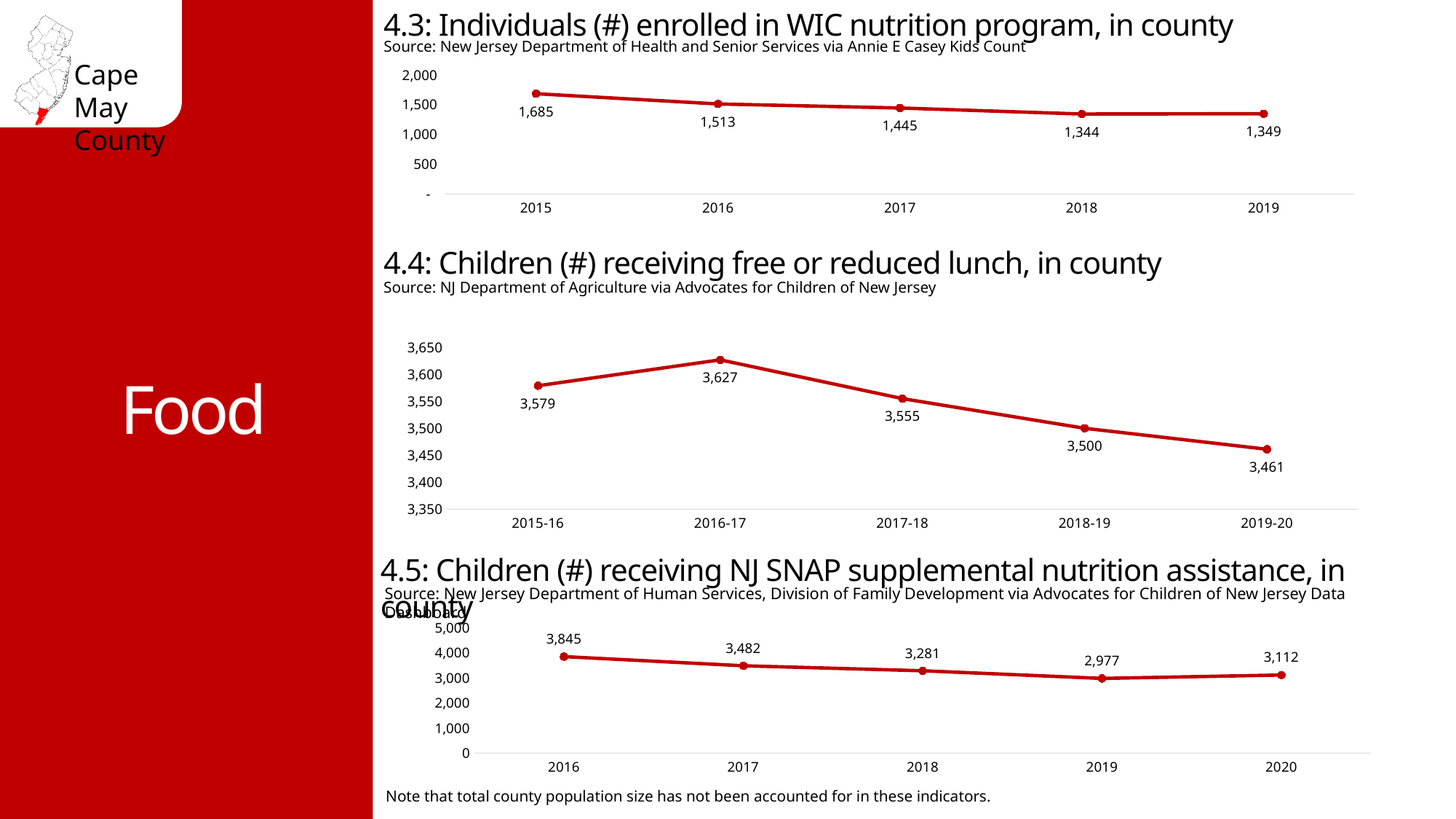
In the chart '4.3: Individuals (#) enrolled in WIC nutrition program, in county', what is the value for 2015? 1,685 In the chart '4.4: Children (#) receiving free or reduced lunch, in county', what is the difference between the 2016-17 and 2019-20 values? 166 In the chart '4.5: Children (#) receiving NJ SNAP supplemental nutrition assistance, in county', what is the value for 2019? 2,977 In the chart '4.4: Children (#) receiving free or reduced lunch, in county', which is larger, the value for 2015-16 or the value for 2019-20? 2015-16 In the chart '4.3: Individuals (#) enrolled in WIC nutrition program, in county', what is the difference between the 2015 and 2019 values? 336 In the chart '4.4: Children (#) receiving free or reduced lunch, in county', what is the value for 2016-17? 3,627 What kind of chart is '4.5: Children (#) receiving NJ SNAP supplemental nutrition assistance, in county'? Line chart In the chart '4.3: Individuals (#) enrolled in WIC nutrition program, in county', which year has the lowest value? 2018 In the chart '4.3: Individuals (#) enrolled in WIC nutrition program, in county', how many years are plotted? 5 In the chart '4.5: Children (#) receiving NJ SNAP supplemental nutrition assistance, in county', which year has the highest value? 2016 In the chart '4.4: Children (#) receiving free or reduced lunch, in county', which school year has the highest value? 2016-17 In the chart '4.5: Children (#) receiving NJ SNAP supplemental nutrition assistance, in county', do the values rise or fall from 2016 to 2019? Fall